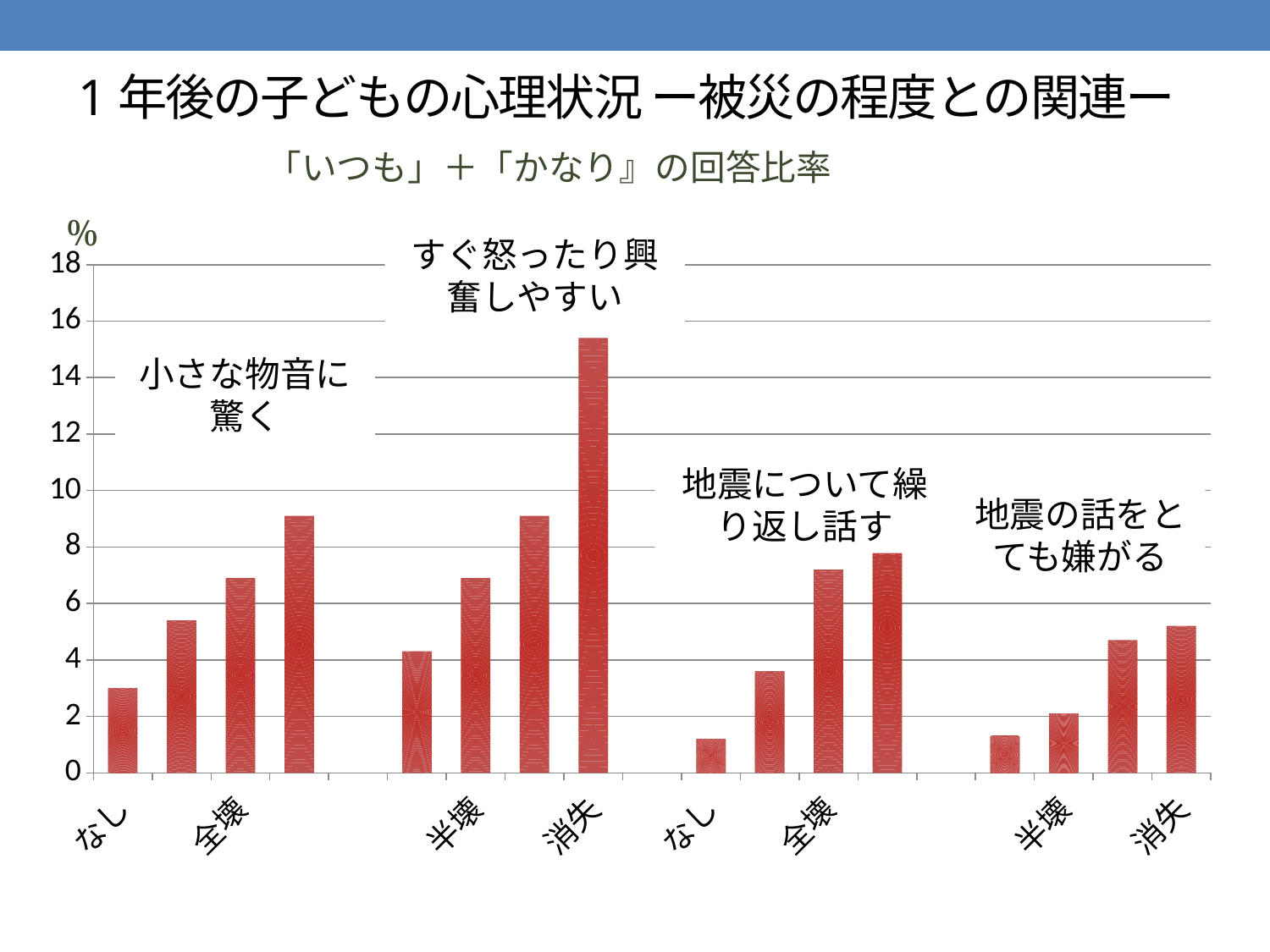
Within each symptom group, do the bars rise or fall from left to right? rise Is the value of the 消失 bar in the すぐ怒ったり興奮しやすい group greater or less than 14? greater Which is larger: the tallest bar in the 地震について繰り返し話す group or the tallest bar in the 地震の話をとても嫌がる group? 地震について繰り返し話す How many symptom groups (labelled clusters of bars) does the chart show? 4 What kind of chart is shown on the slide? bar chart How many bars are plotted in total on the chart? 16 Is the value of the 消失 bar in the 地震の話をとても嫌がる group greater or less than 6? less Which symptom group contains the tallest bar on the chart? すぐ怒ったり興奮しやすい What unit is shown at the top of the vertical axis? % What is the highest tick value shown on the vertical axis? 18 Is the value of the なし bar in the 小さな物音に驚く group greater or less than 4? less Which is larger: the 消失 bar in the すぐ怒ったり興奮しやすい group or the 消失 bar in the 地震の話をとても嫌がる group? すぐ怒ったり興奮しやすい